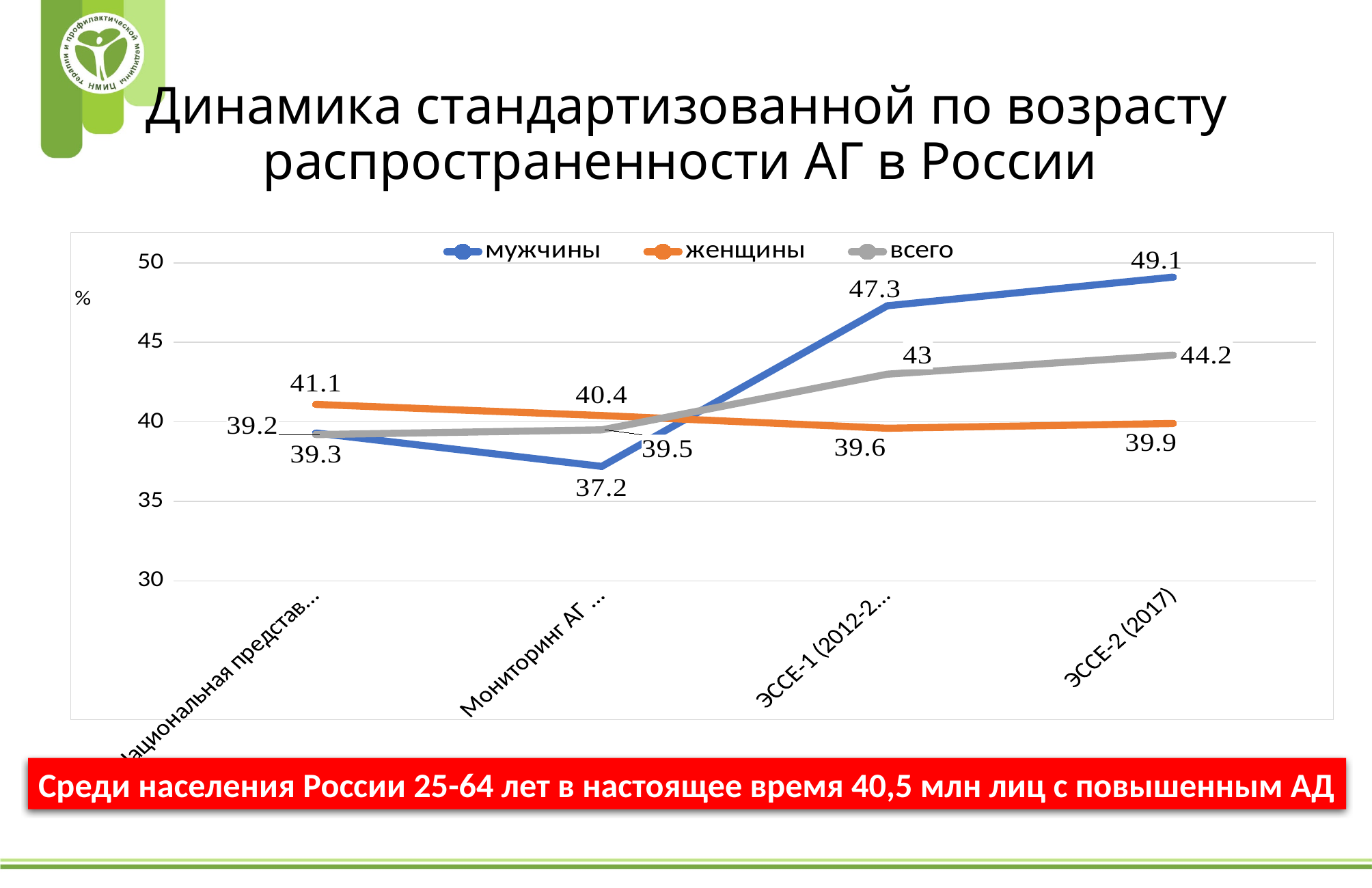
How many categories are plotted along the x axis? 4 What is the value for мужчины at ЭССЕ-2 (2017)? 49.1 What is the value for всего at ЭССЕ-2 (2017)? 44.2 At ЭССЕ-2 (2017), which is larger: мужчины or женщины? мужчины What is the value for женщины at ЭССЕ-2 (2017)? 39.9 How many series does the legend list? 3 What is the lowest value plotted for the мужчины series? 37.2 What kind of chart is shown on the slide? line chart What are the three series named in the legend? мужчины, женщины, всего Does the всего series rise or fall from ЭССЕ-1 to ЭССЕ-2 (2017)? rise What is the value for всего at ЭССЕ-1? 43 What is the difference between мужчины and женщины at ЭССЕ-2 (2017)? 9.2